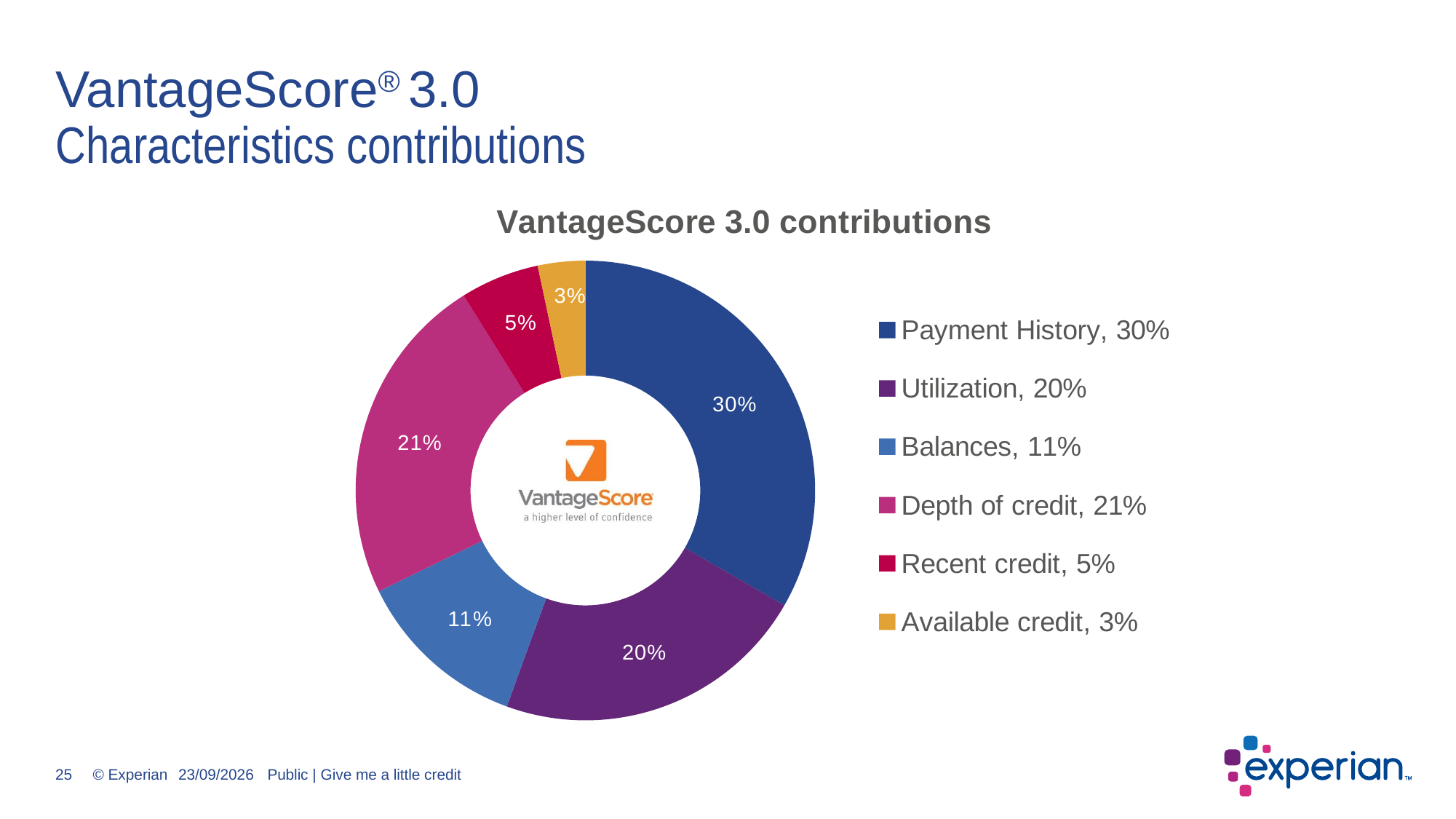
What is the value for Depth of credit? 21% Which category is shown in orange/gold in the chart? Available credit Which category has the smallest share of the chart? Available credit Which category has the largest share of the chart? Payment History What percentage does Payment History contribute in the VantageScore 3.0 contributions chart? 30% What is the title of the chart? VantageScore 3.0 contributions What is the value for Balances? 11% What kind of chart is shown on the slide? Pie chart (doughnut) What is the difference between the Payment History and Utilization shares? 10% What is the combined share of Recent credit and Available credit? 8% Which is larger, Depth of credit or Utilization? Depth of credit How many categories are shown in the chart? 6